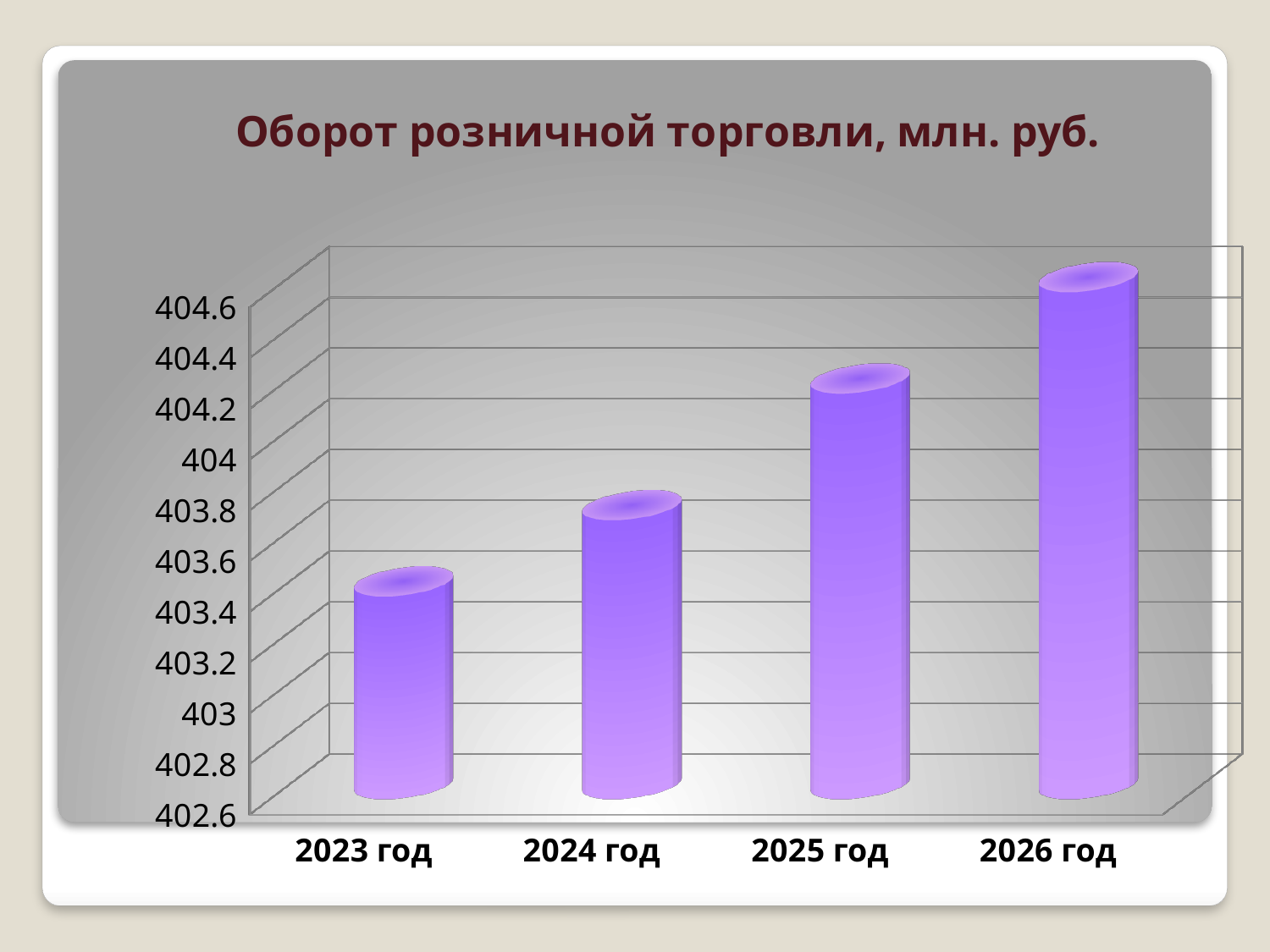
What is the title of the chart? Оборот розничной торговли, млн. руб. Which is larger, the value for 2024 год or the value for 2025 год? 2025 год What type of chart is shown on the slide? bar chart Which year has the lowest value in the chart? 2023 год Which is larger, the value for 2023 год or the value for 2026 год? 2026 год Do the values rise or fall from 2023 год to 2026 год? rise Is the value for 2024 год greater or less than 403.4? greater Is the value for 2025 год greater or less than 404? greater Is the value for 2026 год greater or less than 404.4? greater Which year has the highest value in the chart? 2026 год How many categories (years) are shown on the x axis of the chart? 4